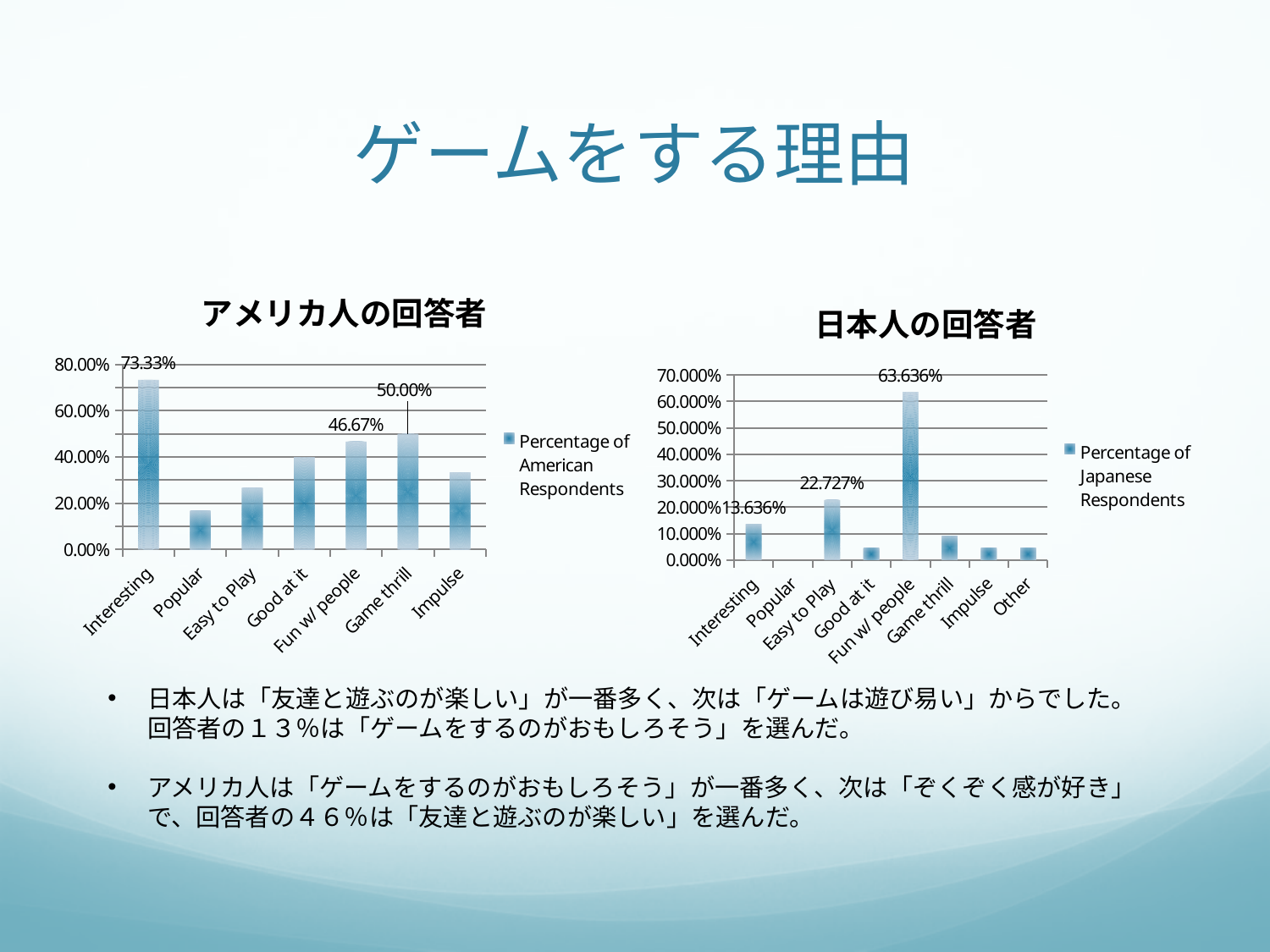
In the 日本人の回答者 chart, what is the difference between Fun w/ people and Easy to Play? 40.909% In the アメリカ人の回答者 chart, is the value for Good at it greater or less than 20.00%? greater In the 日本人の回答者 chart, how many categories are shown on the x axis? 8 In the 日本人の回答者 chart, which category has the highest value? Fun w/ people What type of chart is the 日本人の回答者 chart? Bar chart In the アメリカ人の回答者 chart, how many categories are shown on the x axis? 7 In the アメリカ人の回答者 chart, what is the value for Game thrill? 50.00% In the アメリカ人の回答者 chart, what is the value for Interesting? 73.33% In the アメリカ人の回答者 chart, what is the difference between Game thrill and Fun w/ people? 3.33% In the アメリカ人の回答者 chart, which category has the highest value? Interesting In the 日本人の回答者 chart, what is the value for Fun w/ people? 63.636% In the 日本人の回答者 chart, what is the value for Easy to Play? 22.727%